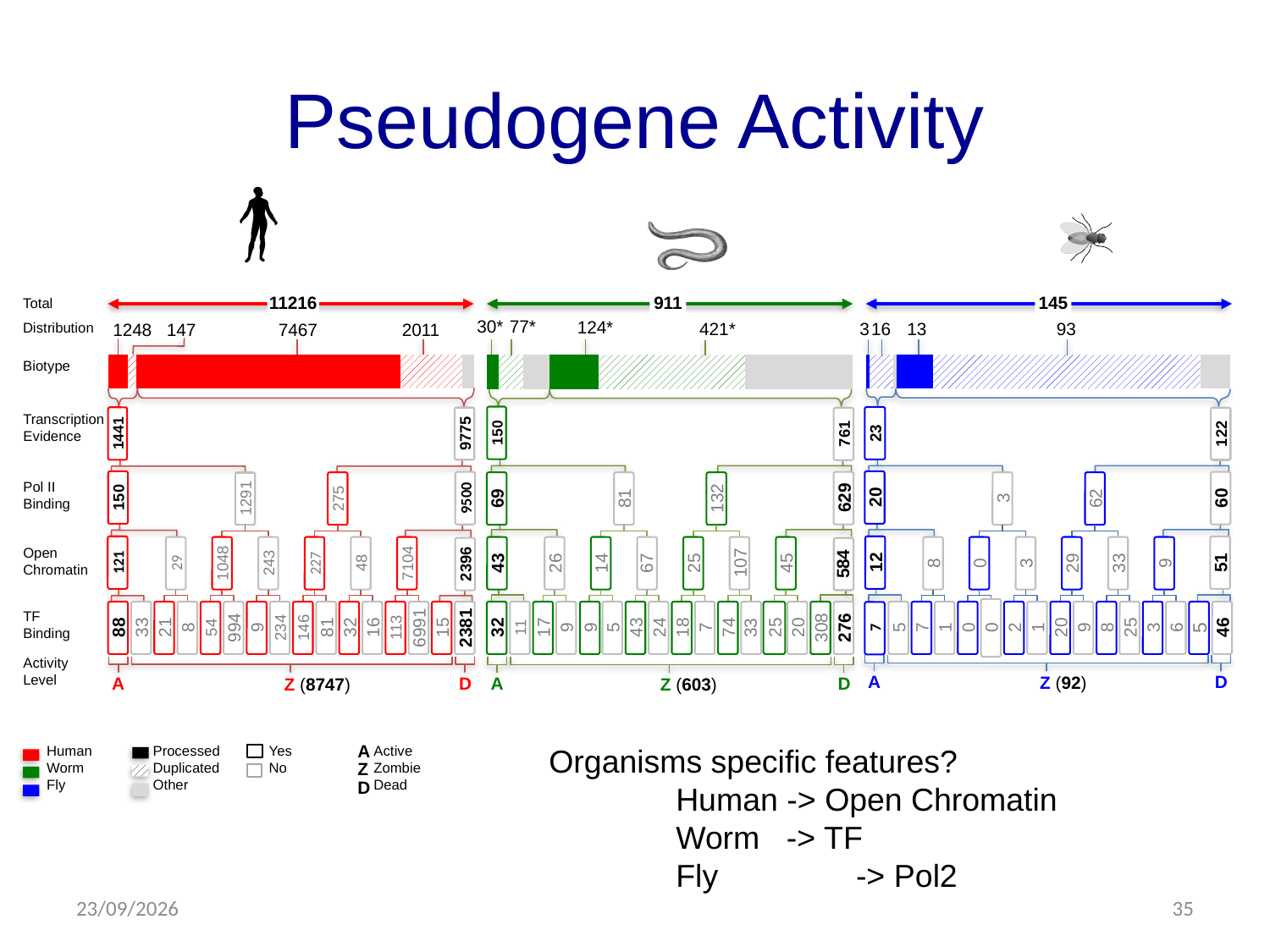
How many pseudogenes are labelled as Zombie (Z) for human? 8747 What is the difference between the human total and the worm total? 10305 What is the total number of pseudogenes shown for human? 11216 How many pseudogenes are labelled as Dead (D) for worm? 276 Which organism has the highest total number of pseudogenes? Human Which organism has the lowest total number of pseudogenes? Fly How many pseudogenes are labelled as Zombie (Z) for fly? 92 How many organisms are shown in the diagram? 3 According to the legend, which colour represents worm? Green What is the total number of pseudogenes shown for fly? 145 What is the total number of pseudogenes shown for worm? 911 How many human pseudogenes have transcription evidence (the 'Yes' box in the Transcription Evidence row)? 1441